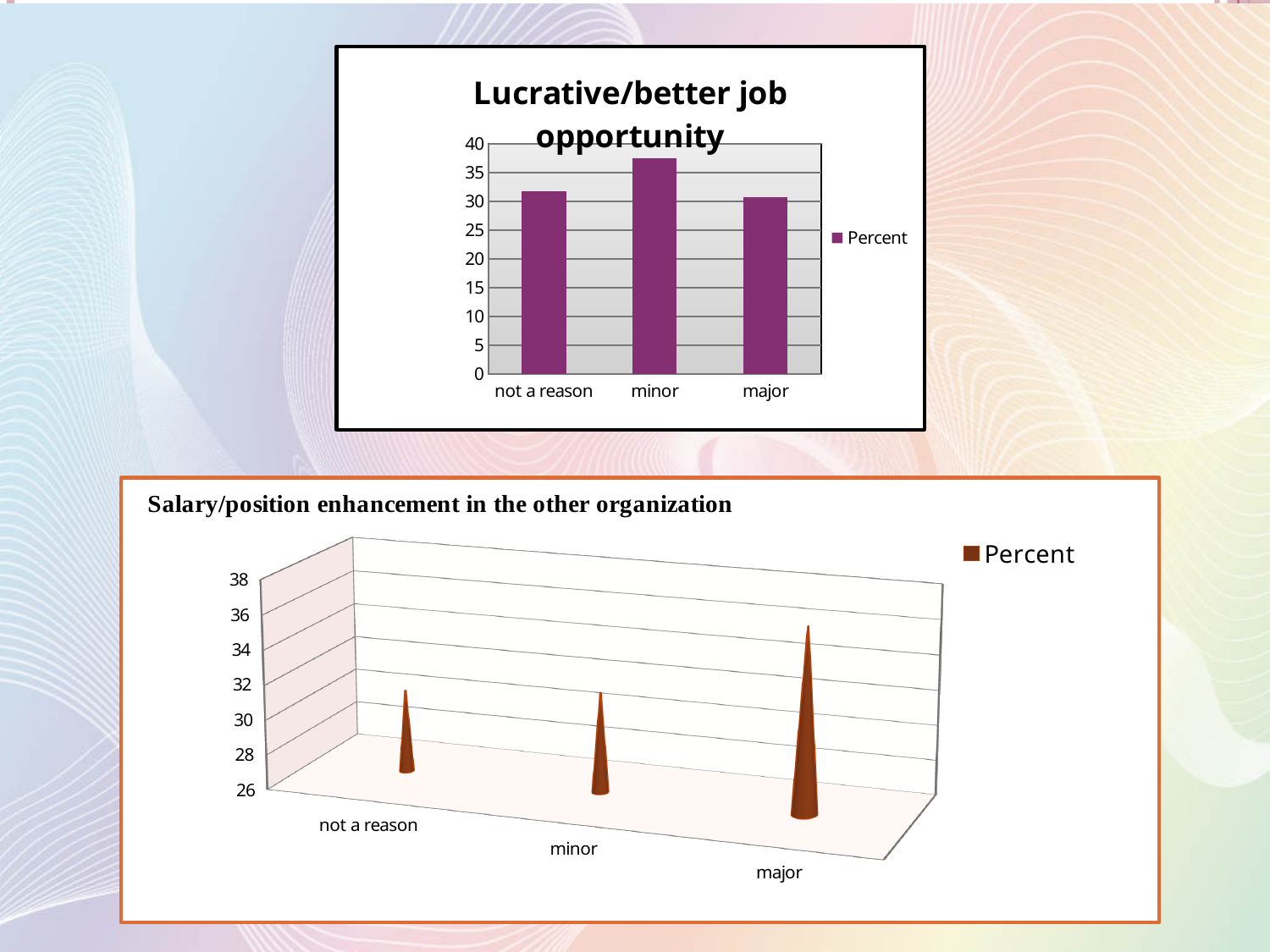
In the 'Salary/position enhancement in the other organization' chart, which category has the highest value? major What is the name of the series in the legend of the 'Lucrative/better job opportunity' chart? Percent In the 'Lucrative/better job opportunity' chart, which is larger, the value for minor or the value for major? minor In the 'Lucrative/better job opportunity' chart, is the value for major greater or less than 35? less How many categories are shown on the x axis of the 'Lucrative/better job opportunity' chart? 3 In the 'Lucrative/better job opportunity' chart, is the value for minor greater or less than 35? greater In the 'Salary/position enhancement in the other organization' chart, is the value for not a reason greater or less than 34? less What kind of chart is the 'Lucrative/better job opportunity' chart? bar chart In the 'Lucrative/better job opportunity' chart, which category has the highest value? minor How many categories are shown in the 'Salary/position enhancement in the other organization' chart? 3 How many series does the legend of the 'Lucrative/better job opportunity' chart list? 1